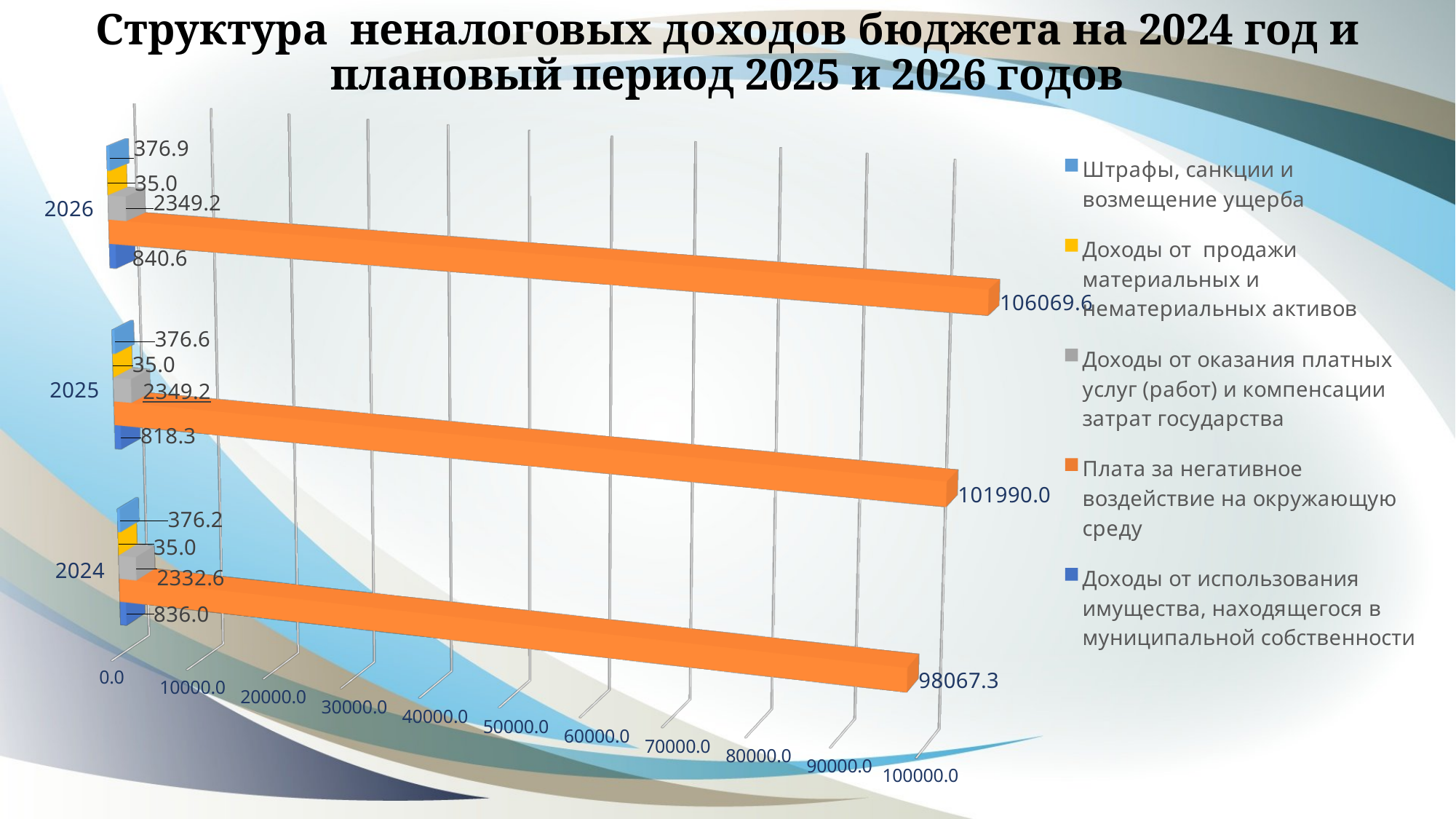
What is the difference between the 2026 and 2025 values of «Плата за негативное воздействие на окружающую среду»? 4079.6 In which year is «Плата за негативное воздействие на окружающую среду» the lowest? 2024 How many series does the legend list? 5 Which is larger: «Доходы от использования имущества» for 2024 or for 2025? 2024 What is the value of «Доходы от использования имущества, находящегося в муниципальной собственности» for 2025? 818.3 How many years (categories) are shown on the chart? 3 In which year is «Плата за негативное воздействие на окружающую среду» the highest? 2026 What is the value of «Плата за негативное воздействие на окружающую среду» for 2026? 106069.6 What is the value of «Штрафы, санкции и возмещение ущерба» for 2025? 376.6 What is the value of «Плата за негативное воздействие на окружающую среду» for 2024? 98067.3 What kind of chart is shown on the slide? Bar chart What is the value of «Доходы от оказания платных услуг (работ) и компенсации затрат государства» for 2024? 2332.6